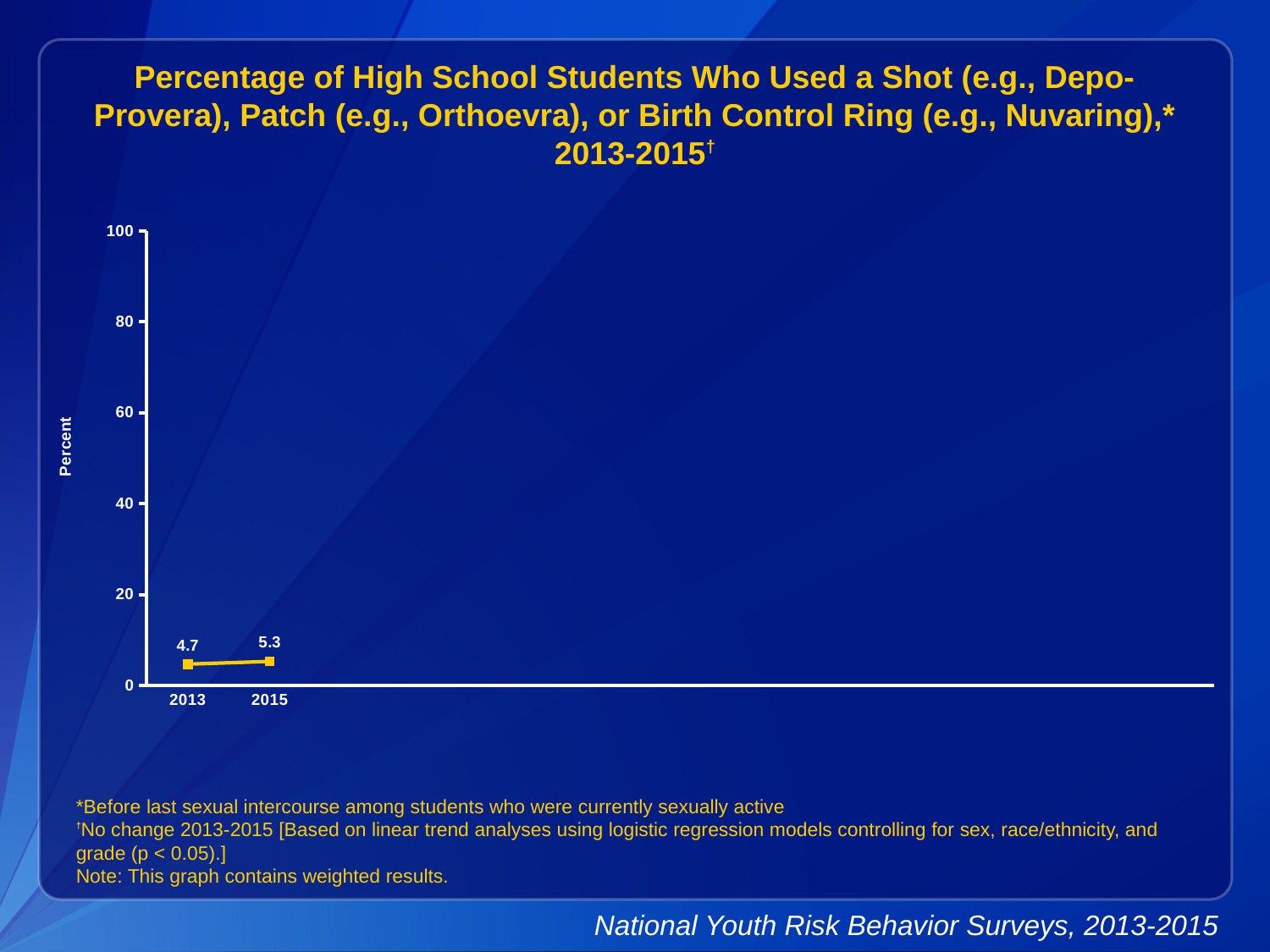
Which year has the higher value? 2015 Which year has the lower value? 2013 What is the value for 2013? 4.7 What is the label on the y axis? Percent What is the difference between the 2015 value and the 2013 value? 0.6 What kind of chart is shown on the slide? line chart Is the value for 2015 greater or less than 20? less What is the maximum value shown on the y axis? 100 How many data points are plotted on the chart? 2 What is the value for 2015? 5.3 Do the values rise or fall from 2013 to 2015? rise